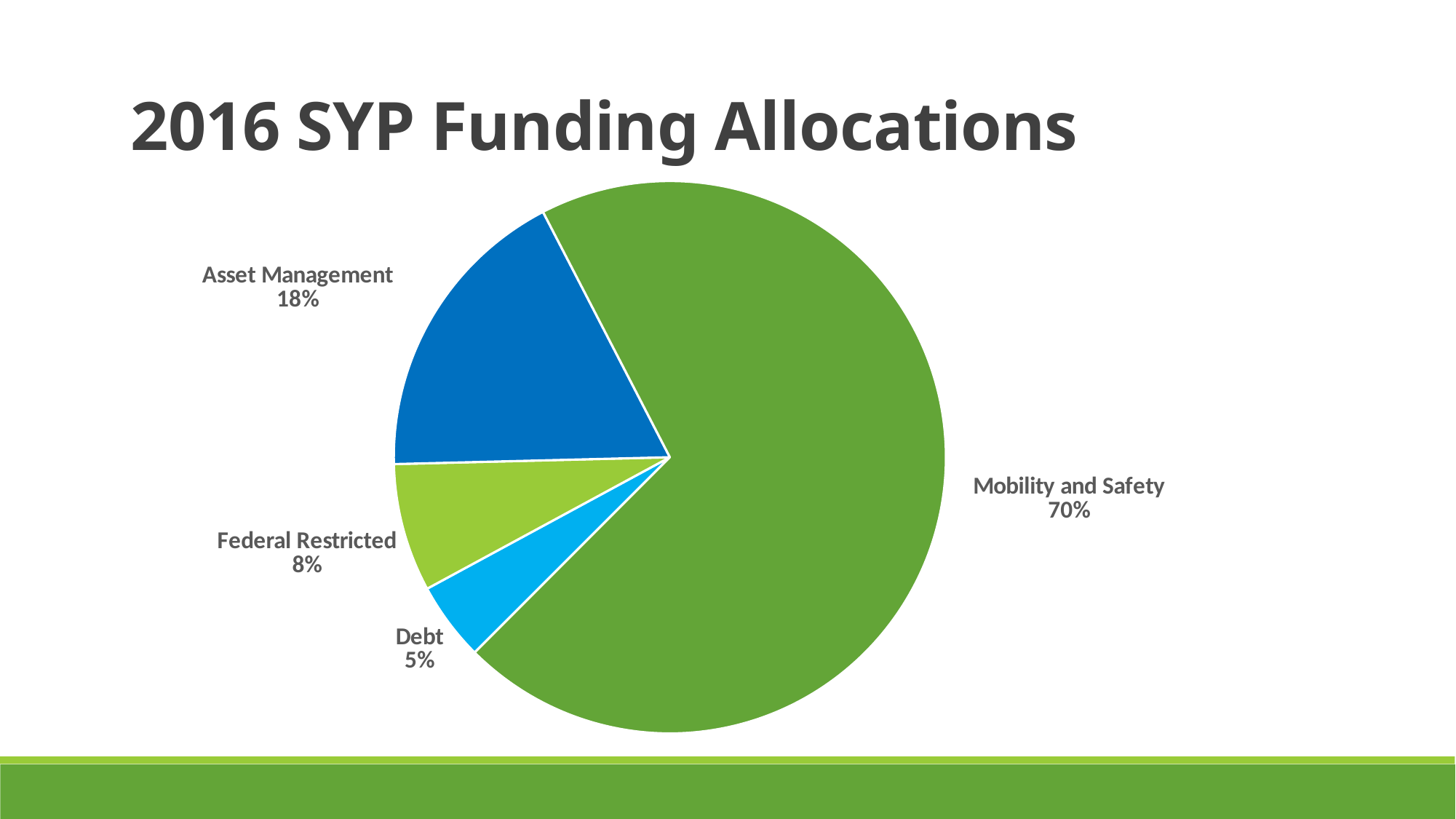
What is the difference in percentage points between Mobility and Safety and Asset Management? 52 What percentage is shown for Debt? 5% How many categories are shown in the pie chart? 4 What share of the pie does Mobility and Safety represent? 70% Which is larger, Asset Management or Federal Restricted? Asset Management What percentage is shown for Asset Management? 18% What is the difference in percentage points between Federal Restricted and Debt? 3 What is the title of the slide? 2016 SYP Funding Allocations What kind of chart is shown on the slide? Pie chart Which category has the largest slice of the pie? Mobility and Safety Which category has the smallest slice of the pie? Debt What percentage is shown for Federal Restricted? 8%